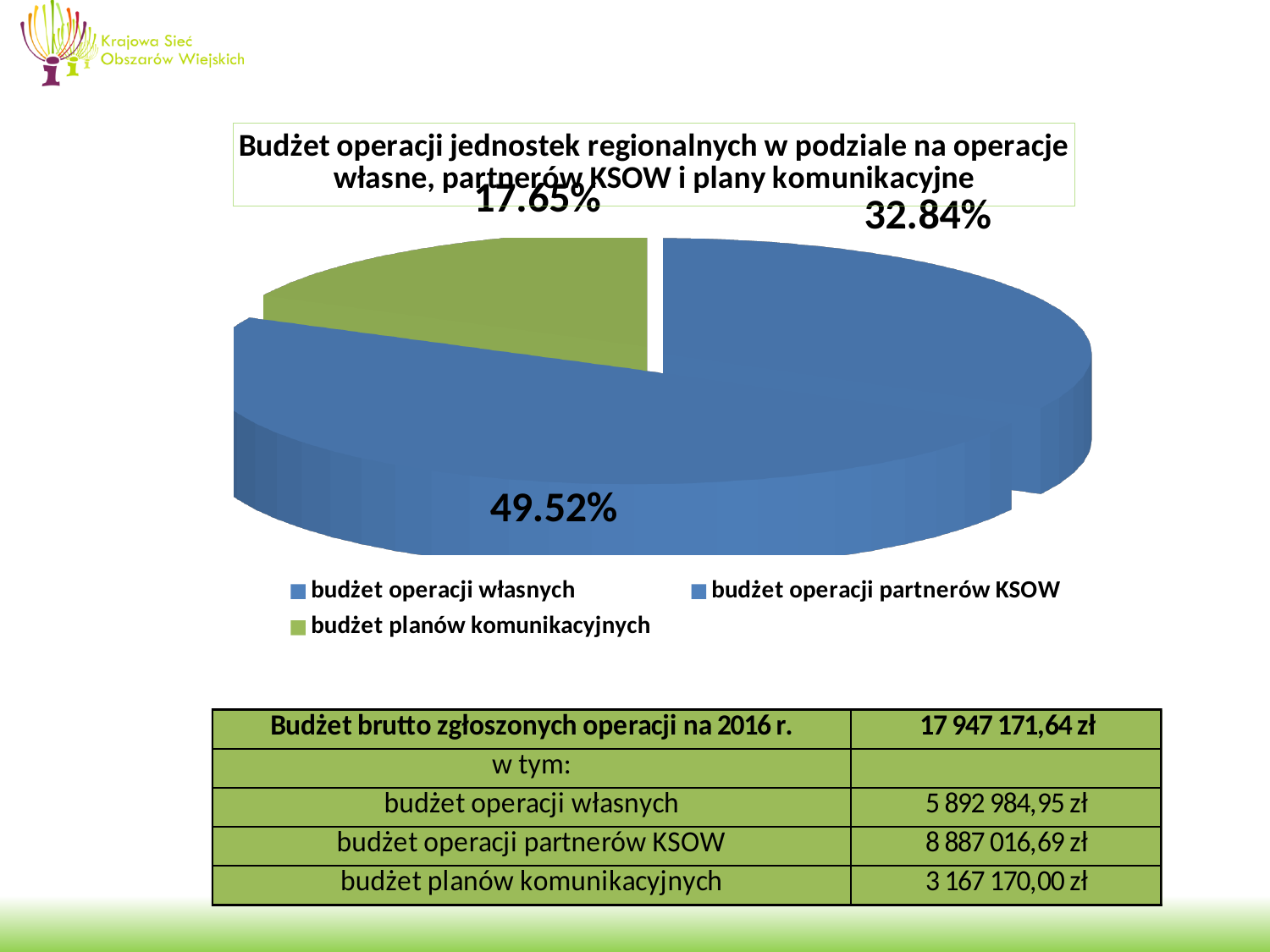
Which category has the smallest share of the pie chart? budżet planów komunikacyjnych How many slices does the pie chart have? 3 Which is larger: the share for budżet operacji własnych or the share for budżet planów komunikacyjnych? budżet operacji własnych What is the title of the pie chart? Budżet operacji jednostek regionalnych w podziale na operacje własne, partnerów KSOW i plany komunikacyjne What percentage of the pie chart is budżet operacji własnych? 32.84% Which category has the largest share of the pie chart? budżet operacji partnerów KSOW What type of chart is shown on the slide? Pie chart What colour is the slice for budżet planów komunikacyjnych? Green By how many percentage points does the largest slice exceed the smallest slice? 31.87 How many entries does the chart legend list? 3 What percentage of the pie chart is budżet planów komunikacyjnych? 17.65% What percentage of the pie chart is budżet operacji partnerów KSOW? 49.52%